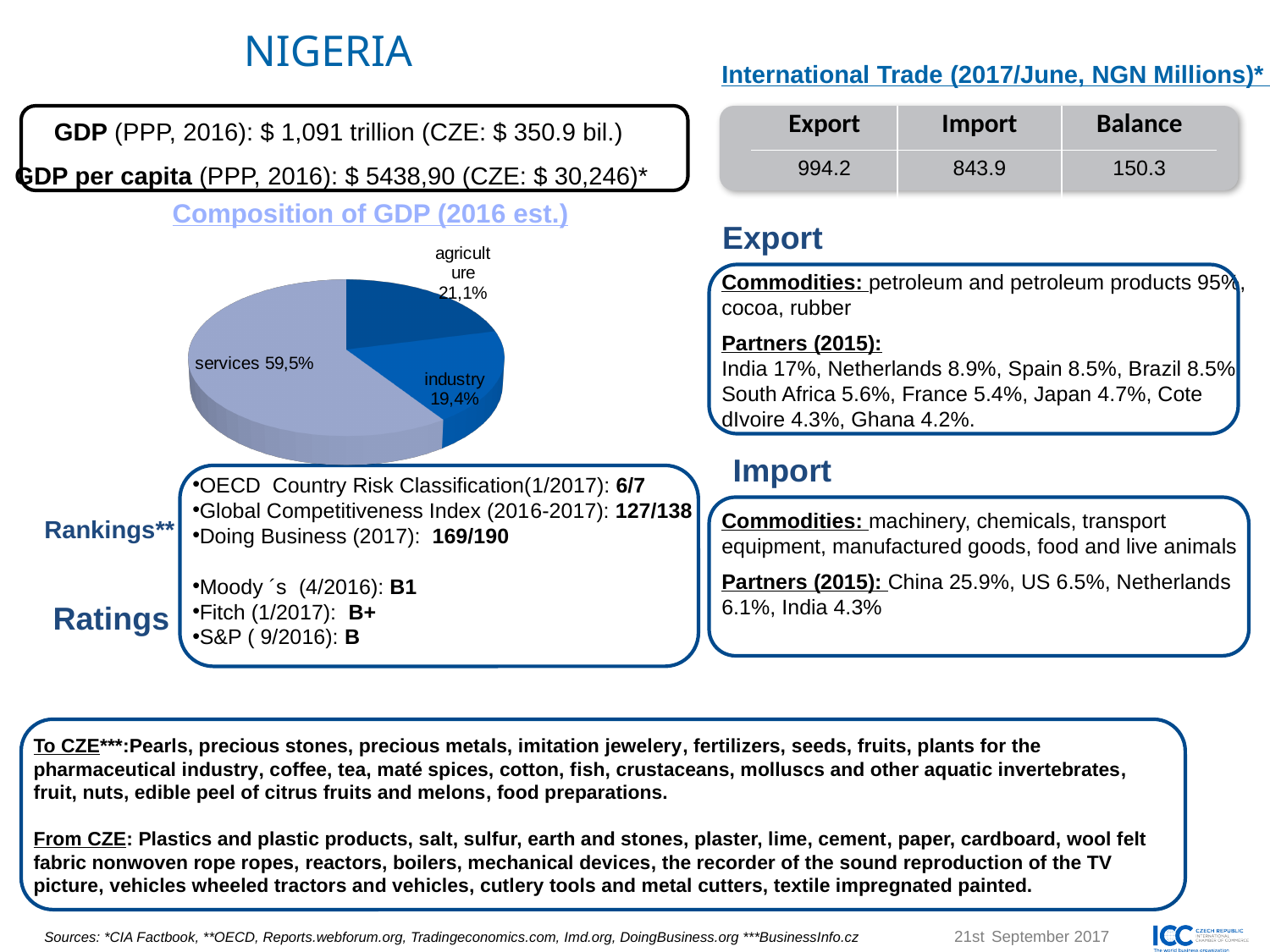
What kind of chart is used to show the Composition of GDP (2016 est.)? pie chart In the Composition of GDP pie chart, what is the difference in percentage points between agriculture and industry? 1,7 How many sectors are shown in the Composition of GDP pie chart? 3 Which sector has the largest share in the Composition of GDP pie chart? services What is the title of the pie chart on the slide? Composition of GDP (2016 est.) What share of GDP does agriculture account for in the Composition of GDP pie chart? 21,1% In the Composition of GDP pie chart, which is larger: agriculture or industry? agriculture What share of GDP does industry account for in the Composition of GDP pie chart? 19,4% In the Composition of GDP pie chart, what is the difference in percentage points between services and agriculture? 38,4 In the Composition of GDP pie chart, what is the combined share of agriculture and industry? 40,5% What share of GDP does services account for in the Composition of GDP pie chart? 59,5% Which sector has the smallest share in the Composition of GDP pie chart? industry